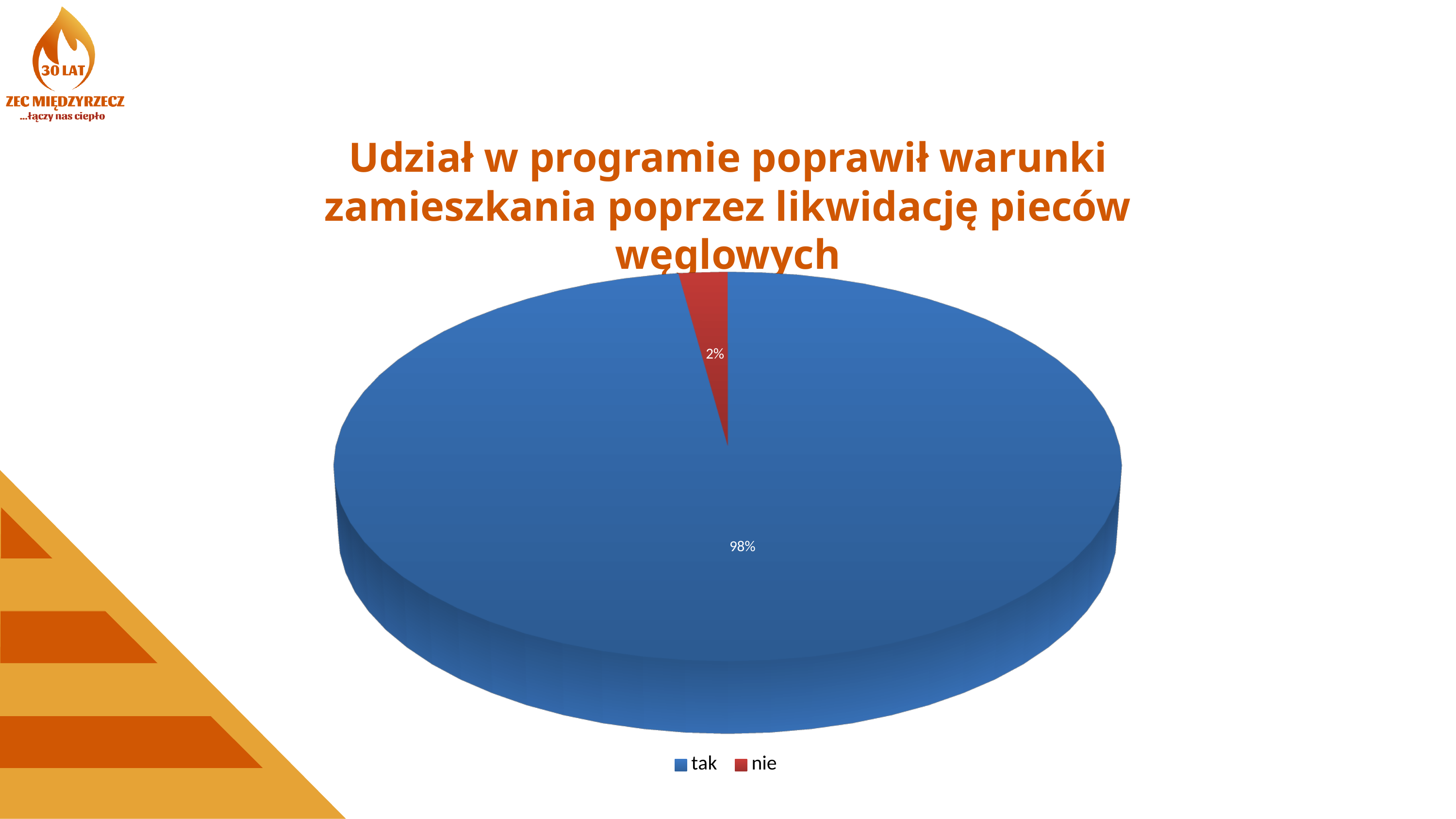
What is the difference in percentage points between the "tak" and "nie" slices? 96 Which slice is larger, "tak" or "nie"? tak What share of the pie does "nie" represent? 2% What share of the pie does "tak" represent? 98% How many categories does the pie chart show? 2 What is the title of the chart? Udział w programie poprawił warunki zamieszkania poprzez likwidację pieców węglowych What colour is the "nie" slice? red Which category has the largest slice of the pie? tak What kind of chart is shown on the slide? pie chart Which category has the smallest slice of the pie? nie